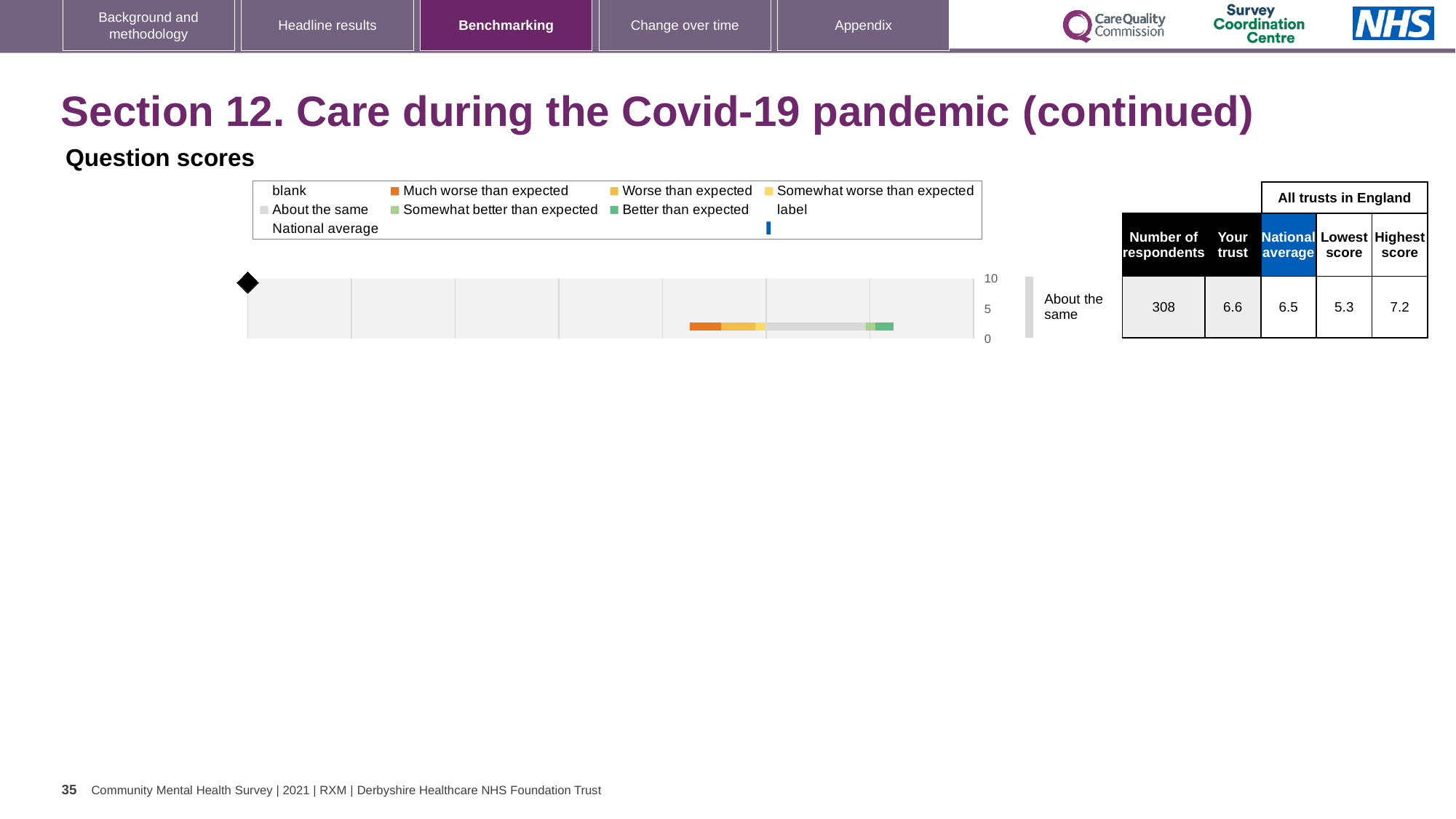
What is the 'Your trust' score shown in the table next to the chart? 6.6 What is the difference between the highest score and the lowest score in the table? 1.9 What benchmark category label is shown beside the bar in the chart? About the same Which colour in the legend represents 'Much worse than expected'? orange How many bars are plotted in the chart? 1 Which is larger, the 'Your trust' score or the national average? Your trust What is the lowest score among all trusts in England shown in the table? 5.3 What is the national average score shown in the table next to the chart? 6.5 What is the number of respondents shown in the table next to the chart? 308 What is the highest score among all trusts in England shown in the table? 7.2 What is the highest tick value shown on the chart's axis? 10 What kind of chart is shown on the slide? bar chart